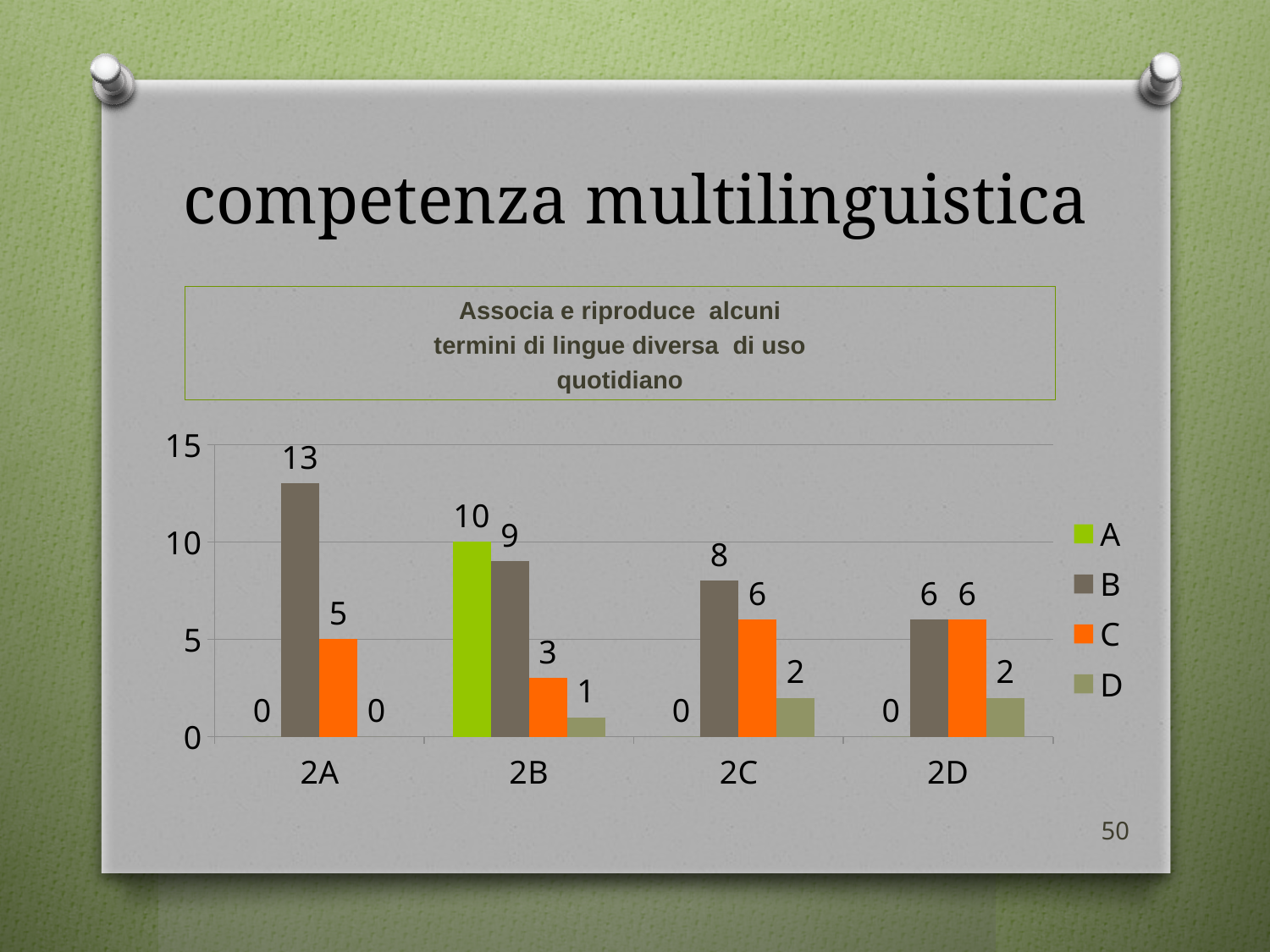
Which category has the highest value for series B? 2A How many series does the legend list? 4 What is the difference between the series B value and the series C value for category 2A? 8 What is the value of series A for category 2B? 10 What kind of chart is shown on the slide? Bar chart What is the value of series B for category 2A? 13 Which is larger for category 2B: the value of series A or the value of series B? Series A What is the value of series C for category 2C? 6 What is the title of the chart? Associa e riproduce alcuni termini di lingue diversa di uso quotidiano How many categories are shown on the x axis? 4 Which category has the lowest value for series C? 2B What is the value of series D for category 2D? 2